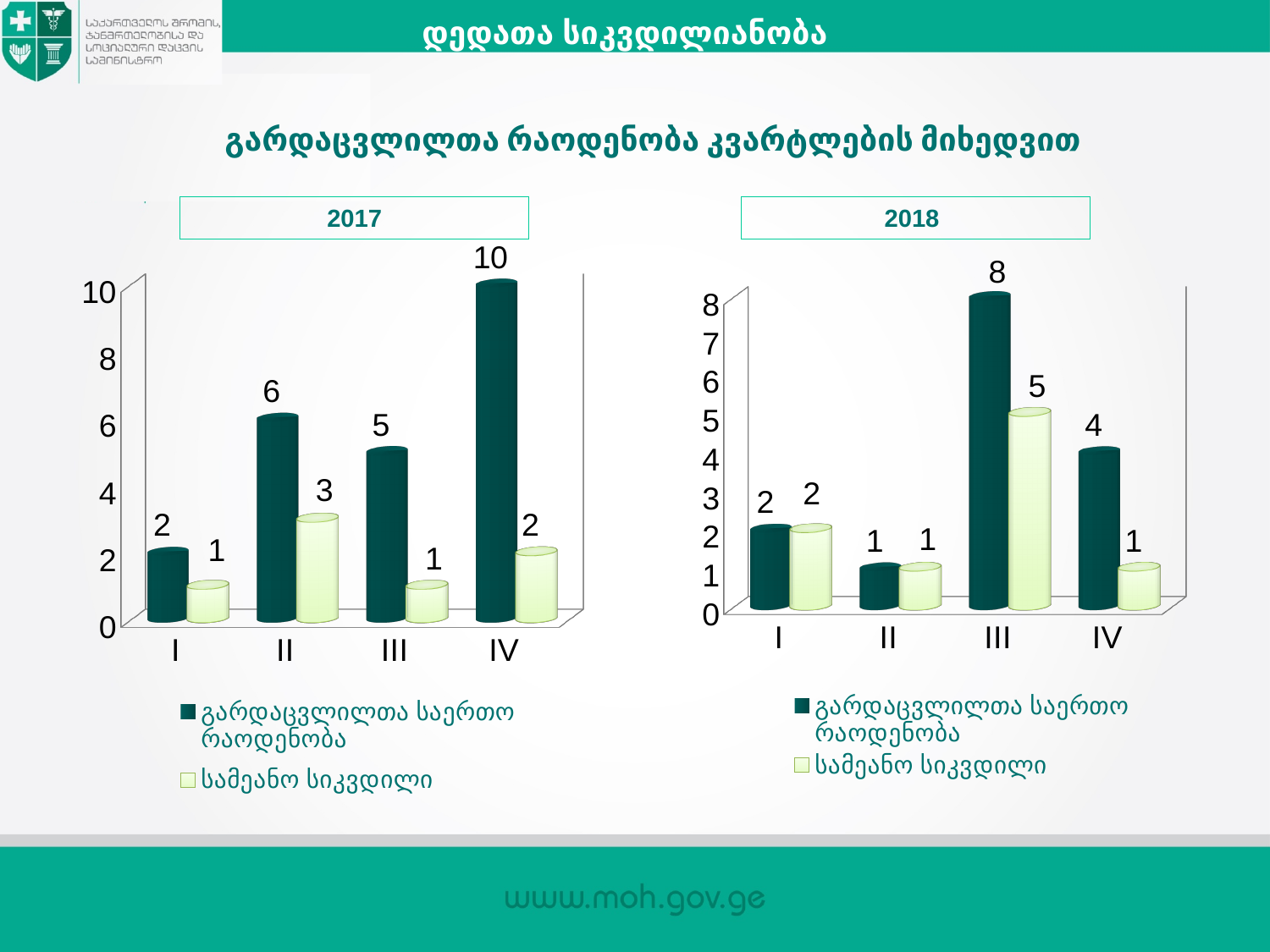
In the 2018 chart, what is the value of სამეანო სიკვდილი for quarter I? 2 How many quarters are shown on the x axis of the 2018 chart? 4 Which is larger: გარდაცვლილთა საერთო რაოდენობა for quarter II in the 2017 chart or for quarter II in the 2018 chart? 2017 In the 2017 chart, what is the difference between გარდაცვლილთა საერთო რაოდენობა and სამეანო სიკვდილი in quarter IV? 8 In the 2017 chart, which quarter has the highest value for გარდაცვლილთა საერთო რაოდენობა? IV What type of chart is the 2018 chart? bar chart How many series does the legend of the 2017 chart list? 2 In the 2017 chart, what is the value of გარდაცვლილთა საერთო რაოდენობა for quarter IV? 10 In the 2018 chart, what is the difference between გარდაცვლილთა საერთო რაოდენობა in quarter III and quarter IV? 4 In the 2018 chart, which quarter has the lowest value for გარდაცვლილთა საერთო რაოდენობა? II In the 2018 chart, what is the value of გარდაცვლილთა საერთო რაოდენობა for quarter III? 8 In the 2017 chart, what is the value of სამეანო სიკვდილი for quarter II? 3